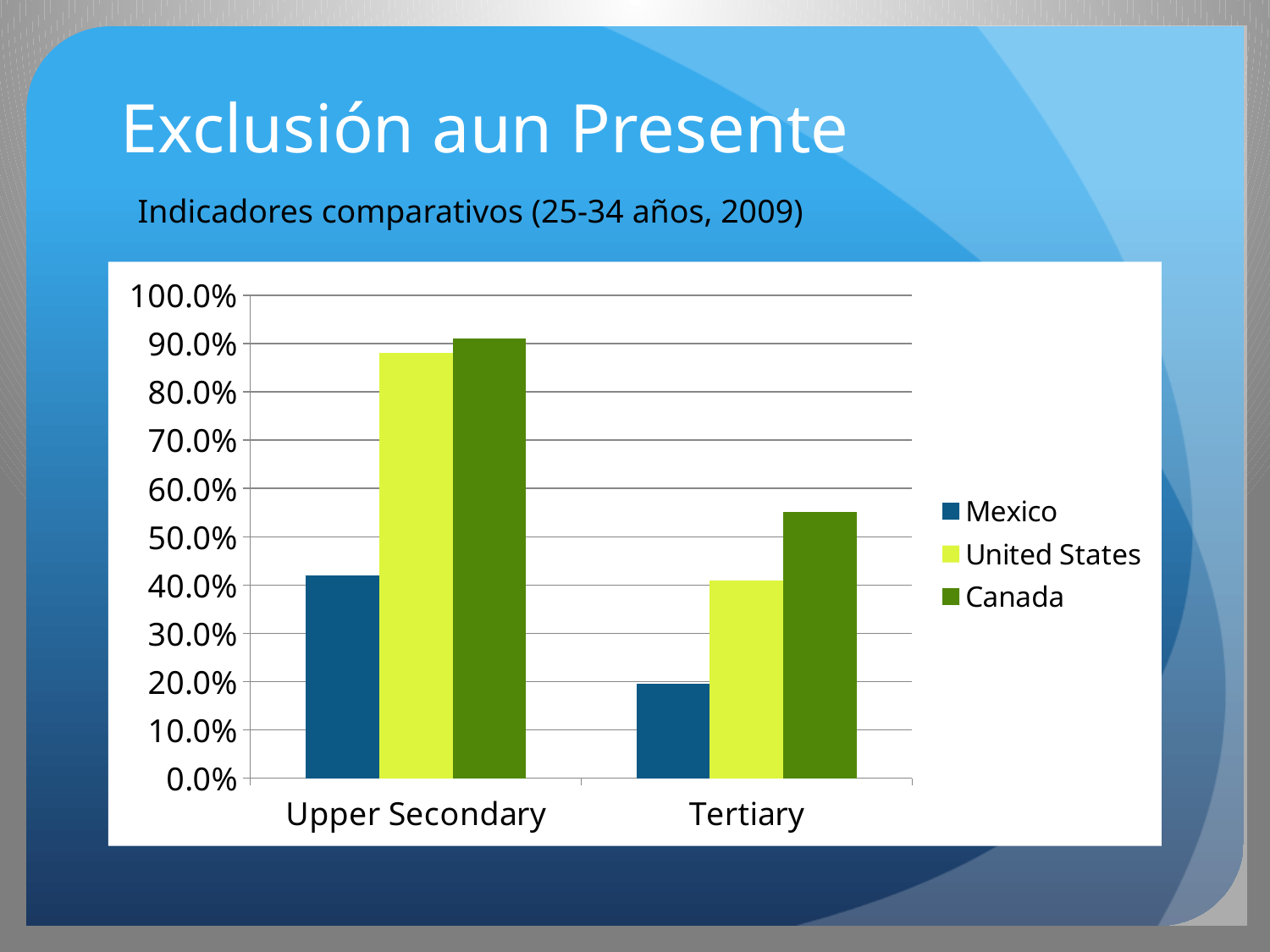
Which country has the lowest value for Upper Secondary? Mexico What kind of chart is shown on the slide? bar chart Which country has the highest value for Upper Secondary? Canada Which is larger: the United States value for Tertiary or the Canada value for Tertiary? Canada Is the value for Mexico in Upper Secondary greater or less than 50.0%? less Is the value for United States in Upper Secondary greater or less than 80.0%? greater Which series is shown in dark blue in the legend? Mexico How many categories are shown on the x axis? 2 Is the value for Mexico in Tertiary greater or less than 30.0%? less Which country has the lowest value for Tertiary? Mexico How many series does the legend list? 3